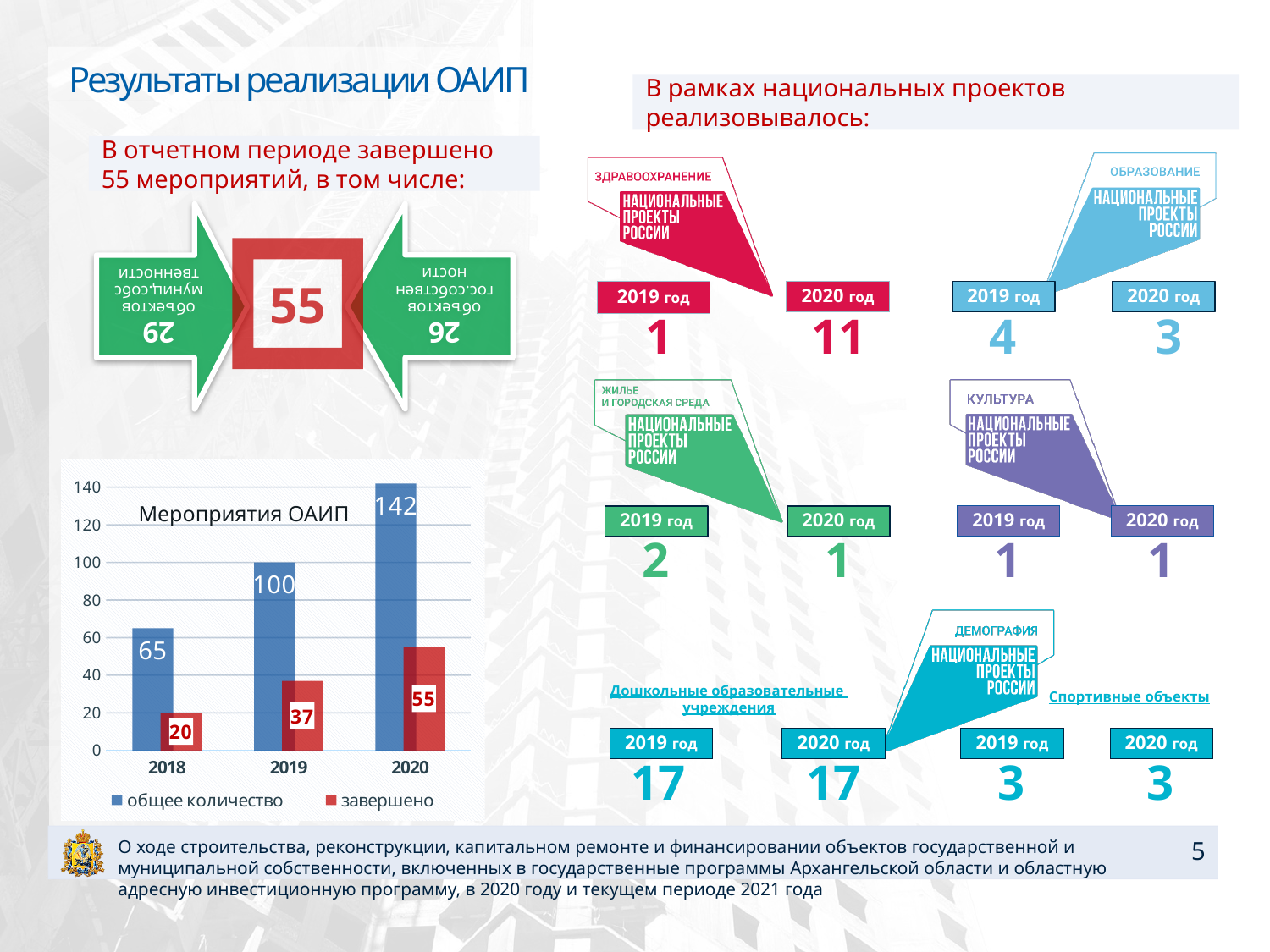
Which year has the highest "общее количество" value in the "Мероприятия ОАИП" chart? 2020 How many series does the legend of the "Мероприятия ОАИП" chart list? 2 What is the value of "завершено" for 2019 in the "Мероприятия ОАИП" chart? 37 Does the "общее количество" series rise or fall from 2018 to 2020 in the "Мероприятия ОАИП" chart? rise How many years are shown on the x axis of the "Мероприятия ОАИП" chart? 3 What is the value of "общее количество" for 2020 in the "Мероприятия ОАИП" chart? 142 By how much did "общее количество" increase from 2018 to 2019 in the "Мероприятия ОАИП" chart? 35 What is the difference between "общее количество" and "завершено" for 2020 in the "Мероприятия ОАИП" chart? 87 What is the value of "общее количество" for 2018 in the "Мероприятия ОАИП" chart? 65 What type of chart is "Мероприятия ОАИП"? bar chart In the "Мероприятия ОАИП" chart, which is larger: "завершено" for 2019 or "завершено" for 2020? 2020 Which year has the lowest "завершено" value in the "Мероприятия ОАИП" chart? 2018